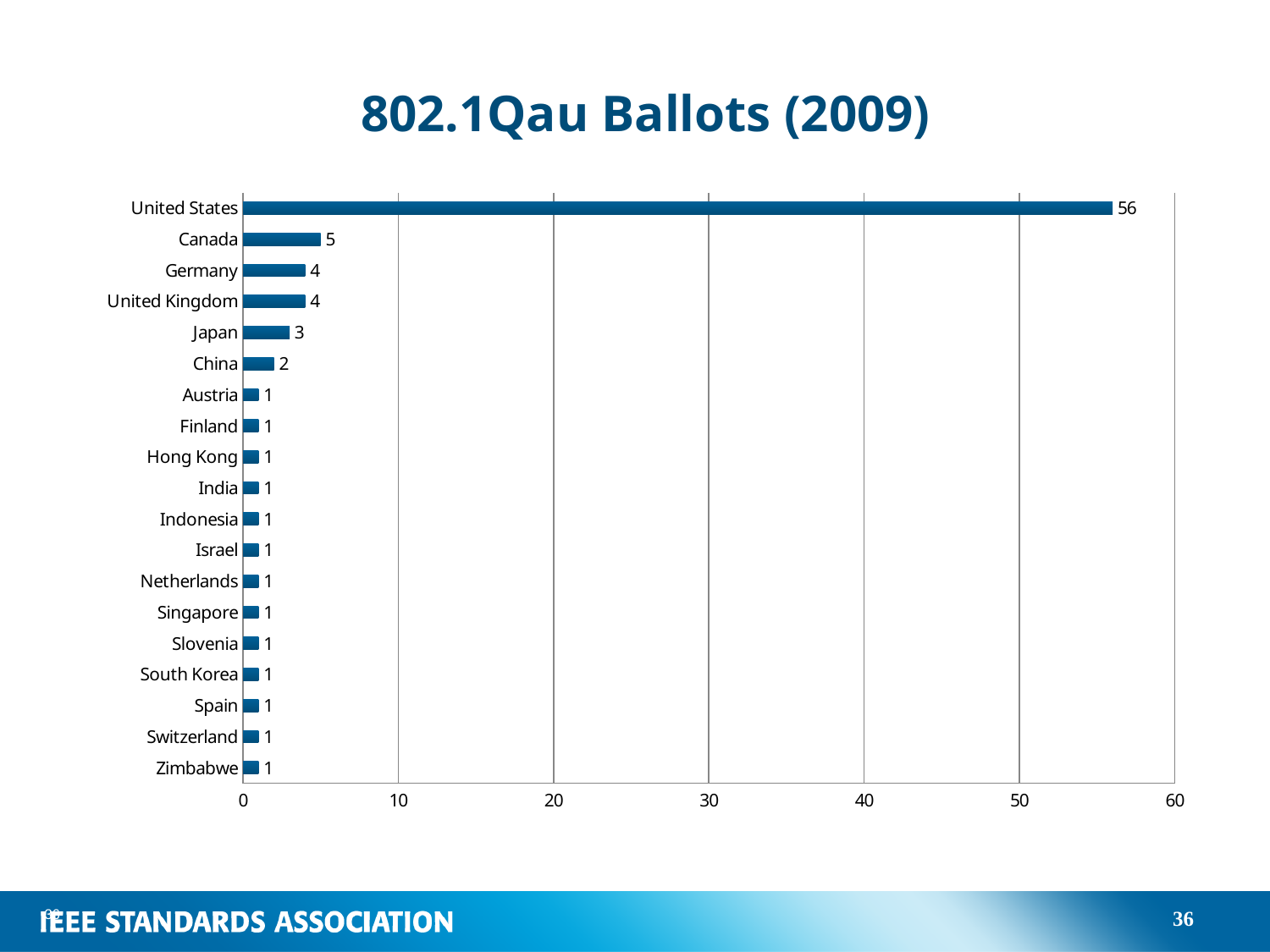
Which is larger, the value for Canada or the value for Japan? Canada What is the difference between the values for Germany and China? 2 What is the value for United States? 56 What is the value for China? 2 What is the value for Canada? 5 What is the title of the chart? 802.1Qau Ballots (2009) How many countries are shown on the chart? 19 Is the value for United States greater or less than 50? greater What is the value for Japan? 3 What kind of chart is shown on the slide? bar chart Which country has the highest value? United States What is the difference between the values for United States and Canada? 51